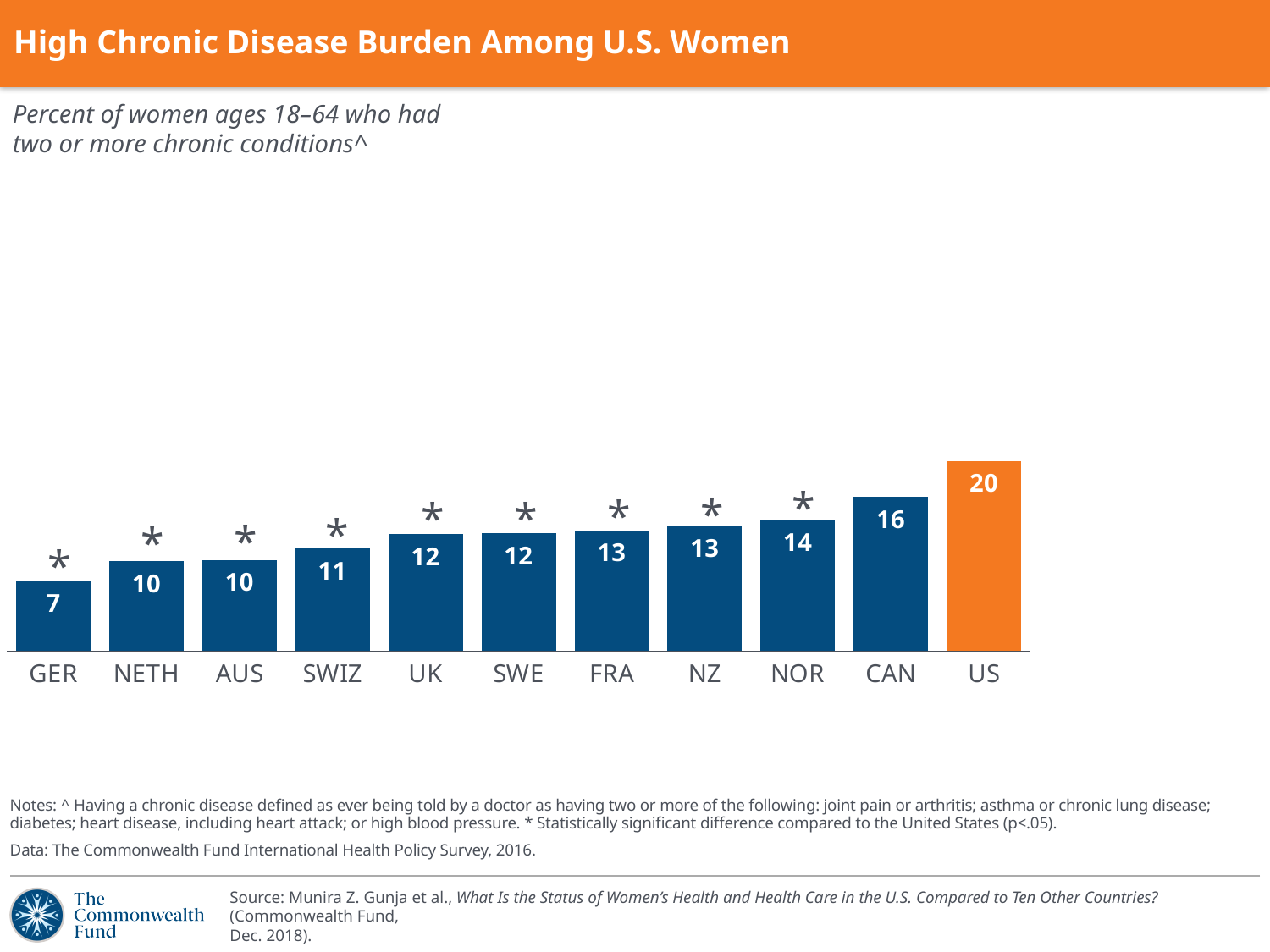
What kind of chart is shown on the slide? bar chart Do the values rise or fall from left to right along the x axis? rise How many countries are shown in the chart? 11 Which country has the highest value? US What is the value for NOR? 14 Which bar is coloured orange rather than blue? US Which country has the lowest value? GER What is the value for the US? 20 What is the difference between the values for the US and GER? 13 What is the value for GER? 7 Which is larger, the value for SWIZ or the value for NOR? NOR What is the difference between the values for the US and CAN? 4